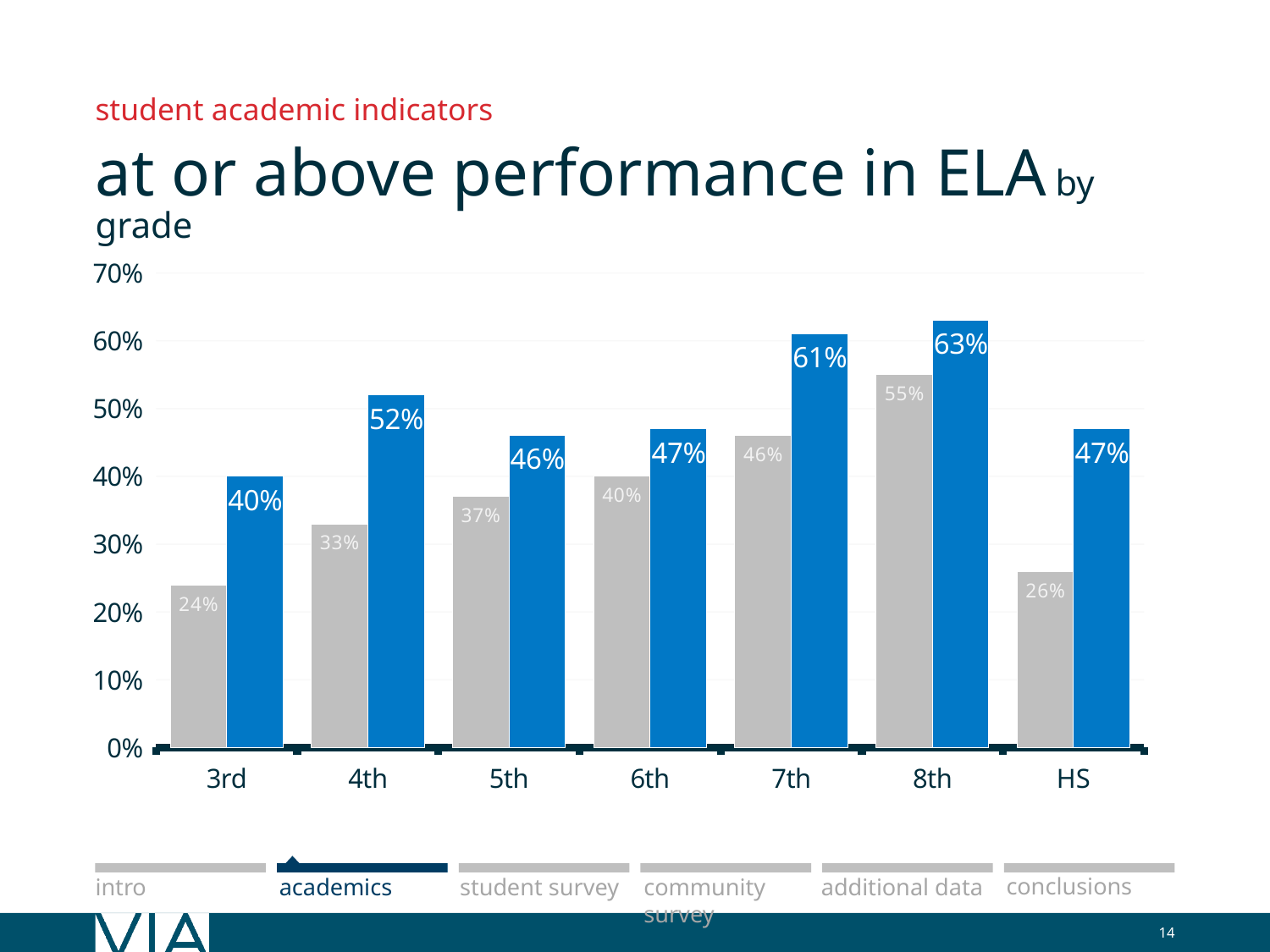
Which is larger for 5th grade, the gray bar or the blue bar? the blue bar What is the value of the gray bar for 3rd grade? 24% What is the value of the gray bar for 7th grade? 46% Is the gray bar for 8th grade greater or less than 50%? greater What is the value of the blue bar for 8th grade? 63% What kind of chart is shown on the slide? bar chart How many grade categories are shown on the x axis? 7 What is the value of the blue bar for HS? 47% Which grade has the lowest gray bar? 3rd What is the difference between the blue bar and the gray bar for 4th grade? 19% What is the title of the chart? at or above performance in ELA by grade Which grade has the highest blue bar? 8th